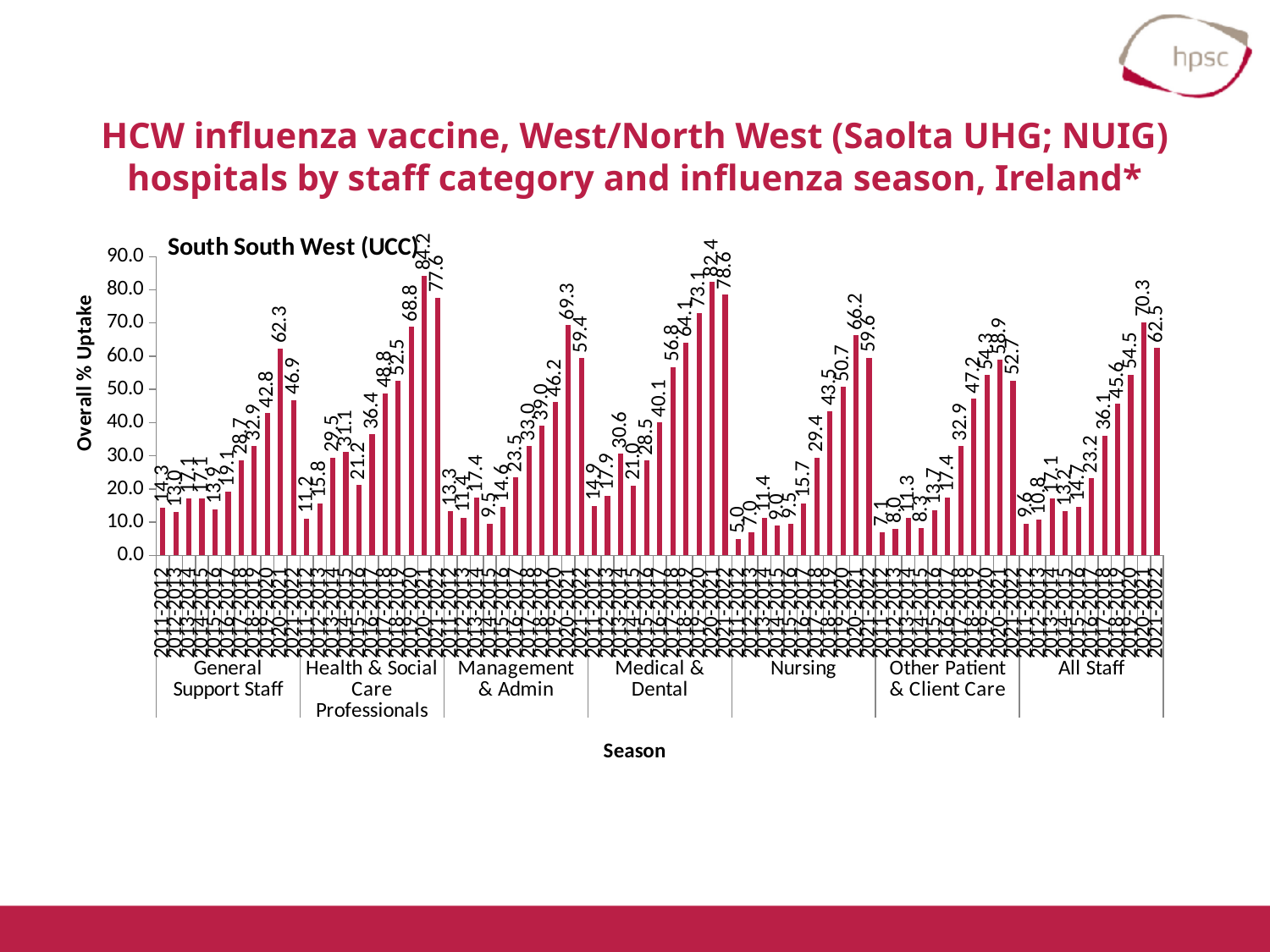
What is the value of the tallest bar in the All Staff group? 70.3 What is the difference between the tallest bar in the Medical & Dental group (82.4) and the tallest bar in the All Staff group (70.3)? 12.1 What is the value of the tallest bar in the Nursing group? 66.2 What is the highest value plotted anywhere on the chart? 84.2 What is the title of the y axis on the chart? Overall % Uptake What is the lowest value plotted in the Nursing group? 5.0 Which staff category contains the tallest bar on the chart? Health & Social Care Professionals Which is larger: the tallest bar in the Management & Admin group or the tallest bar in the Nursing group? Management & Admin Within each staff category, do the values generally rise or fall from the first season to the 2020-2021 season? rise What kind of chart is shown on the slide? bar chart What is the value of the last (rightmost) bar in the Health & Social Care Professionals group? 77.6 How many staff categories are shown along the x axis of the chart? 7